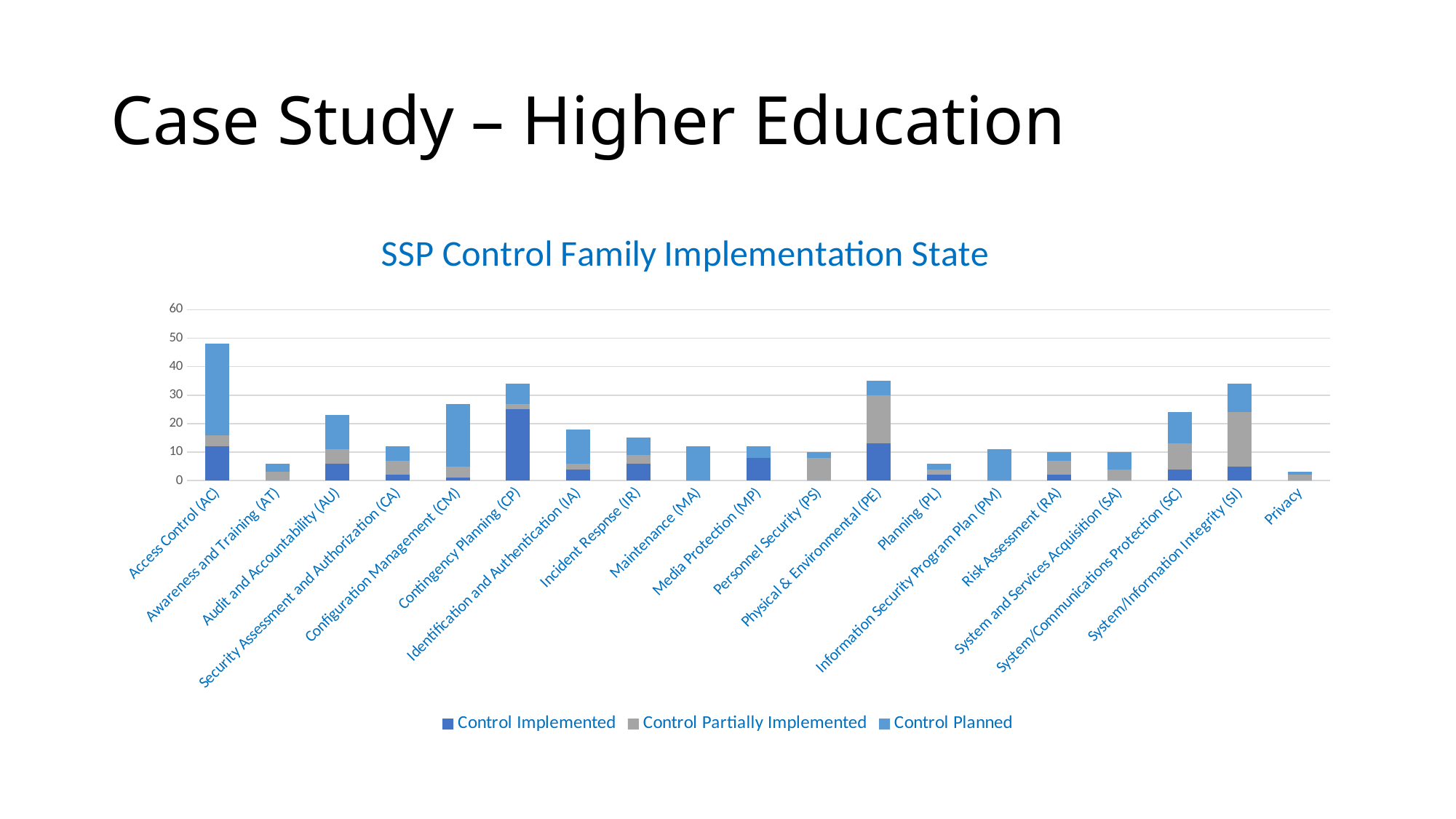
What kind of chart is shown on the slide? Stacked bar chart Which has the taller stacked bar, Contingency Planning (CP) or Configuration Management (CM)? Contingency Planning (CP) Is the total bar height for Privacy greater or less than 10? less Is the total bar height for Contingency Planning (CP) greater or less than 30? greater Is the total bar height for Access Control (AC) greater or less than 40? greater Which control family has the shortest stacked bar? Privacy How many series does the legend list? 3 Which series is shown in dark blue in the legend? Control Implemented What is the title of the chart? SSP Control Family Implementation State How many control family categories are shown on the x axis? 19 Which control family has the tallest stacked bar? Access Control (AC)